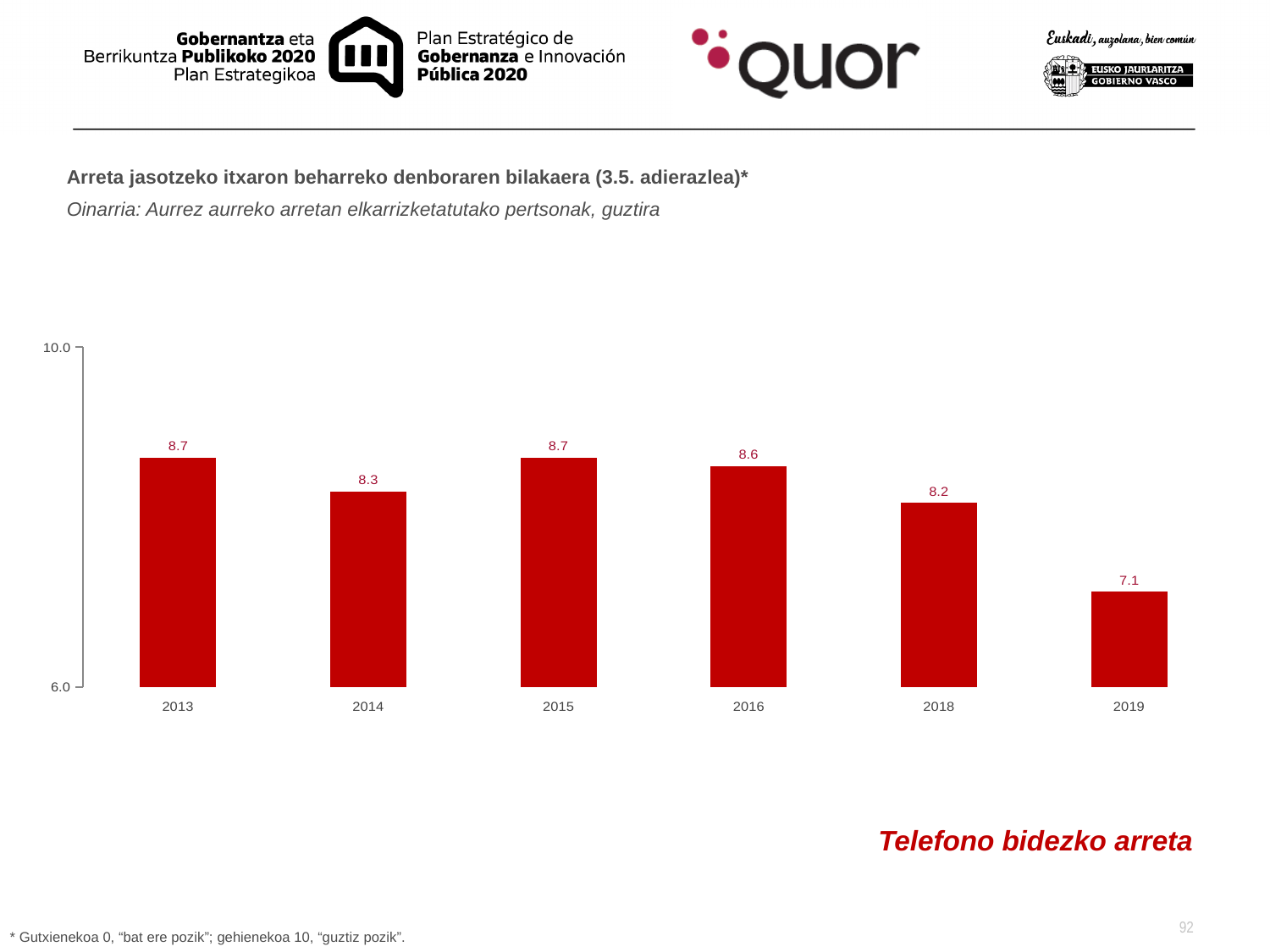
Do the values generally rise or fall from 2016 to 2019? fall What is the value for 2013? 8.7 What is the value for 2019? 7.1 Which is larger, the value for 2014 or the value for 2016? 2016 What kind of chart is shown on the slide? bar chart Is the value for 2019 greater or less than 8.0? less What is the maximum value shown on the y axis? 10.0 How many years are shown on the x axis? 6 Which year has the lowest value? 2019 What is the difference between the values for 2016 and 2018? 0.4 What is the difference between the values for 2013 and 2019? 1.6 What is the value for 2018? 8.2